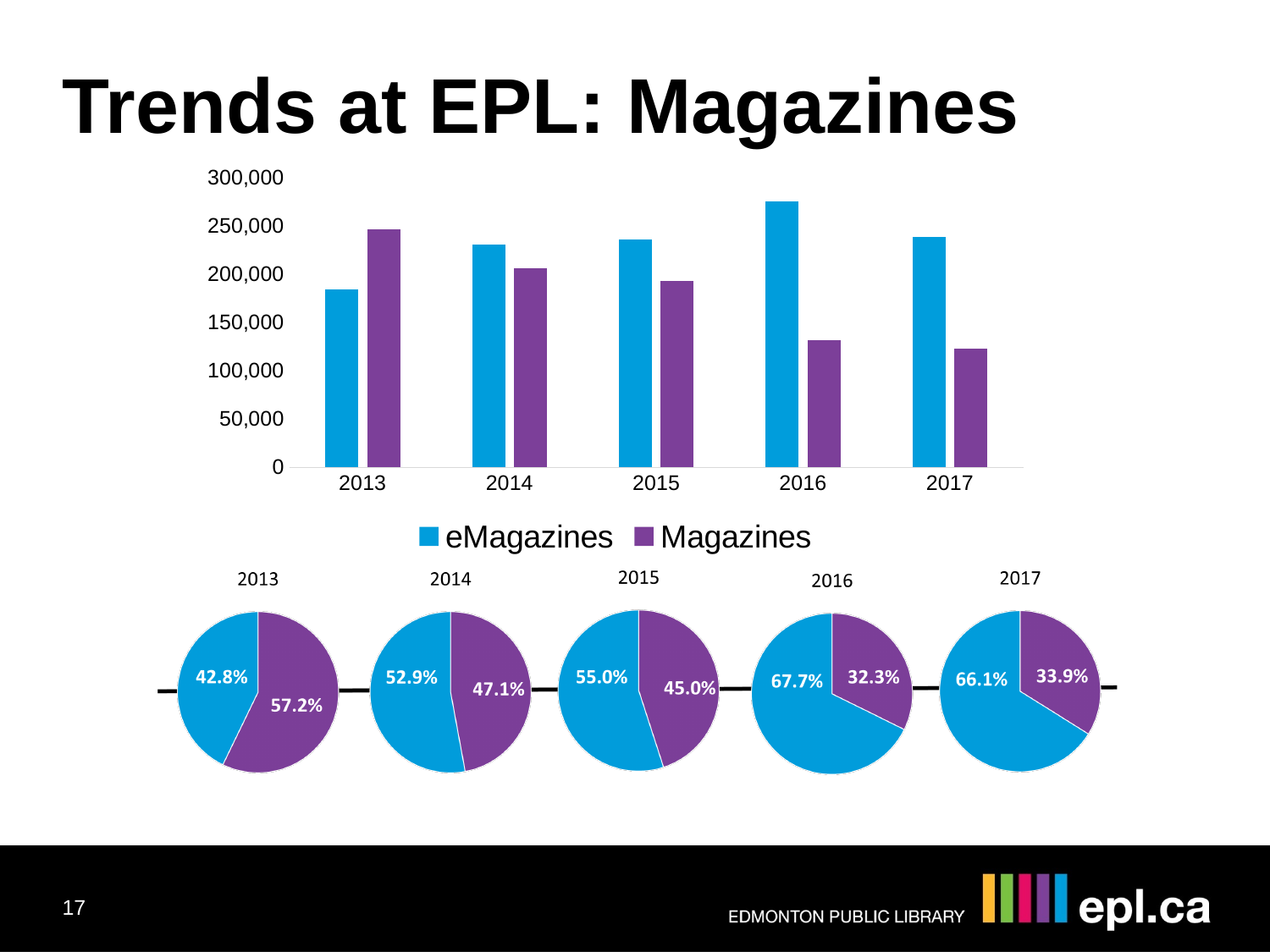
How many series does the legend of the bar chart list? 2 In the 2013 pie chart, what share is shown for the Magazines (purple) slice? 57.2% In the bar chart, do the Magazines values rise or fall from 2013 to 2017? fall In the bar chart, which year has the highest Magazines bar? 2013 How many years are shown on the x axis of the bar chart? 5 In the 2016 pie chart, what share is shown for the eMagazines (blue) slice? 67.7% In the bar chart, which year has the highest eMagazines bar? 2016 What type of chart is the upper chart on the slide? bar chart Across the five pie charts, which year shows the largest eMagazines (blue) share? 2016 In the bar chart, is the value for eMagazines in 2016 greater or less than 250,000? greater In the bar chart, is the value for Magazines in 2017 greater or less than 150,000? less In the bar chart, is the value for eMagazines in 2013 greater or less than 200,000? less